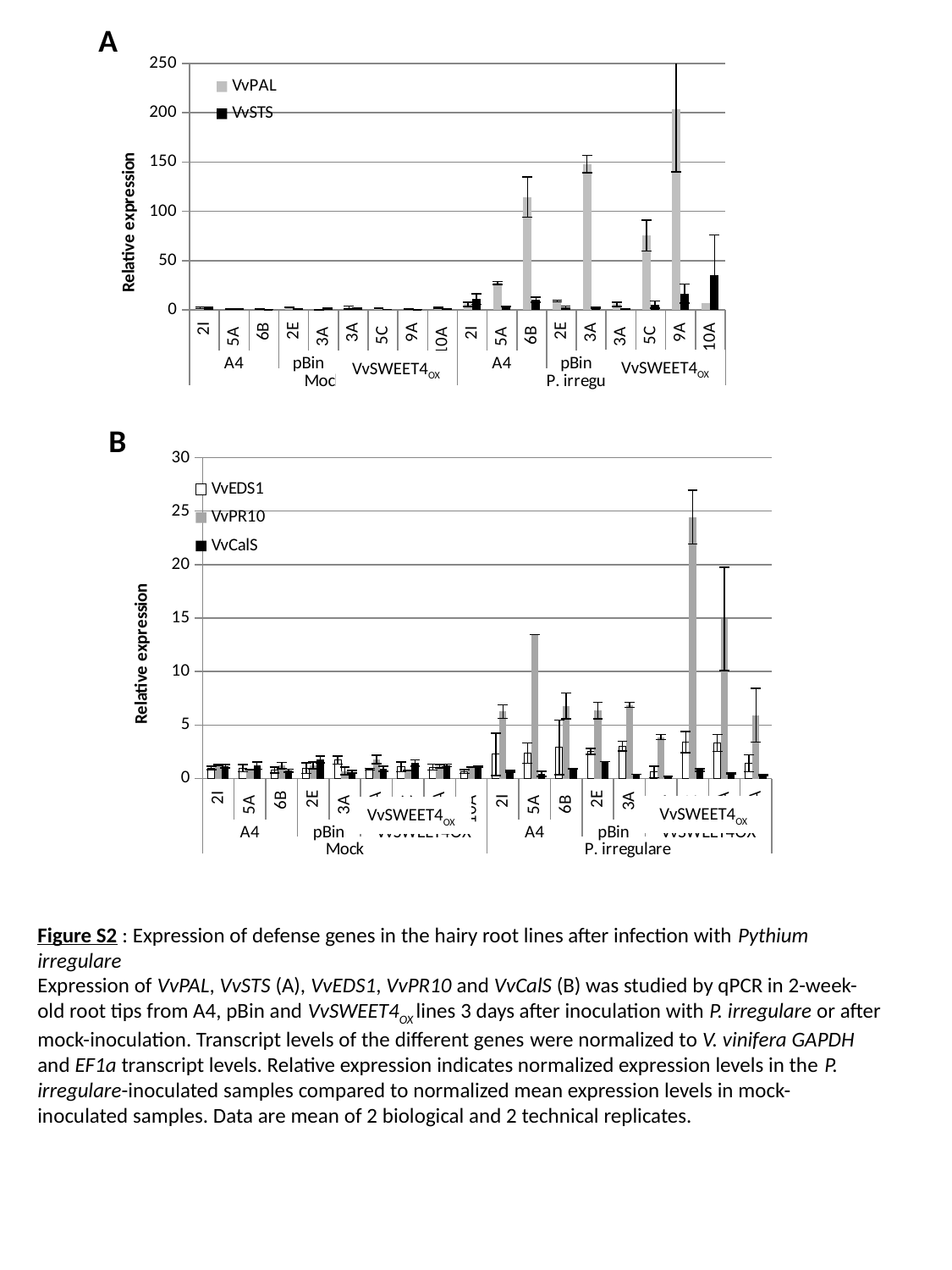
In chart B, is the VvPR10 value for 5A (A4, P. irregulare) greater or less than 10? greater In chart A, which category has the highest VvPAL value? 9A (VvSWEET4OX, P. irregulare) What kind of chart is chart A? bar chart How many series does the legend of chart B list? 3 In chart A, is the VvPAL value for 3A (pBin, P. irregulare) greater or less than 100? greater In chart A, what is the y-axis title? Relative expression In chart A, how many categories are shown along the x axis? 18 In chart A, which series are listed in the legend? VvPAL and VvSTS In chart A, is the VvSTS value for 10A (VvSWEET4OX, P. irregulare) greater or less than 50? less How many series does the legend of chart A list? 2 In chart A, which is larger: the VvPAL value for 3A (pBin, P. irregulare) or for 6B (A4, P. irregulare)? 3A (pBin, P. irregulare)